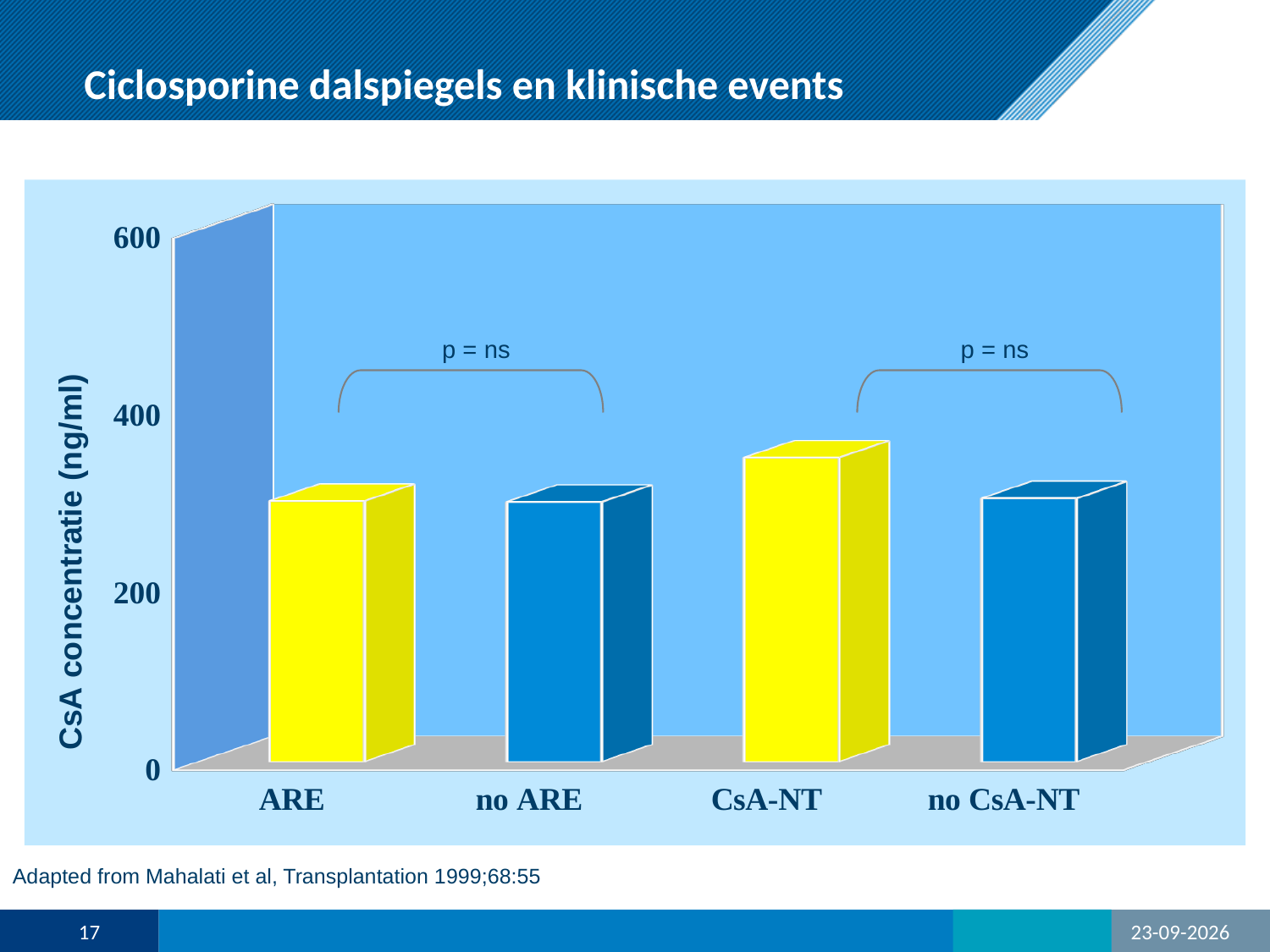
How many categories are shown on the x axis of the chart? 4 What kind of chart is shown on the slide? bar chart What is the title of the slide containing the chart? Ciclosporine dalspiegels en klinische events Is the value for CsA-NT greater or less than 400? less Is the value for ARE greater or less than 200? greater Is the value for no CsA-NT greater or less than 200? greater Which is larger, the value for CsA-NT or the value for no CsA-NT? CsA-NT Which is larger, the value for CsA-NT or the value for ARE? CsA-NT What is the label of the y axis of the chart? CsA concentratie (ng/ml) Which category has the highest CsA concentration in the chart? CsA-NT What is the highest tick value shown on the y axis of the chart? 600